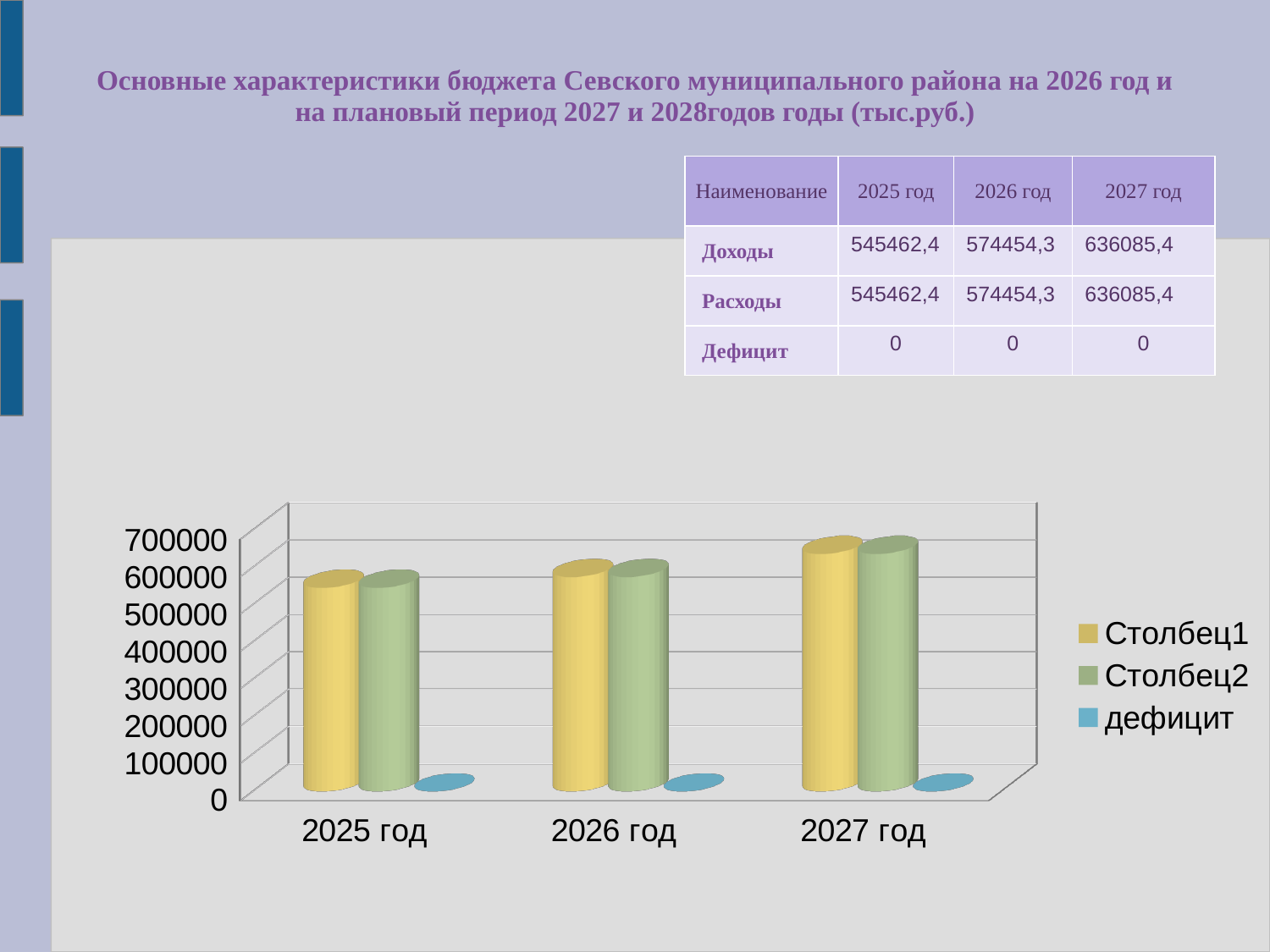
Which is larger in the chart: Столбец1 for 2027 год or Столбец1 for 2025 год? 2027 год Is the value for Столбец2 in 2027 год greater or less than 600000? greater How many year categories are shown on the x axis of the chart? 3 Is the value for Столбец1 in 2025 год greater or less than 500000? greater Which year has the lowest value for Столбец2 in the chart? 2025 год Is the value for Столбец1 in 2025 год greater or less than 600000? less How many series does the chart legend list? 3 Which year has the highest value for Столбец1 in the chart? 2027 год Which series in the chart legend is shown in blue? дефицит Do the values for Столбец1 rise or fall from 2025 год to 2027 год? rise What kind of chart is shown on the slide? bar chart